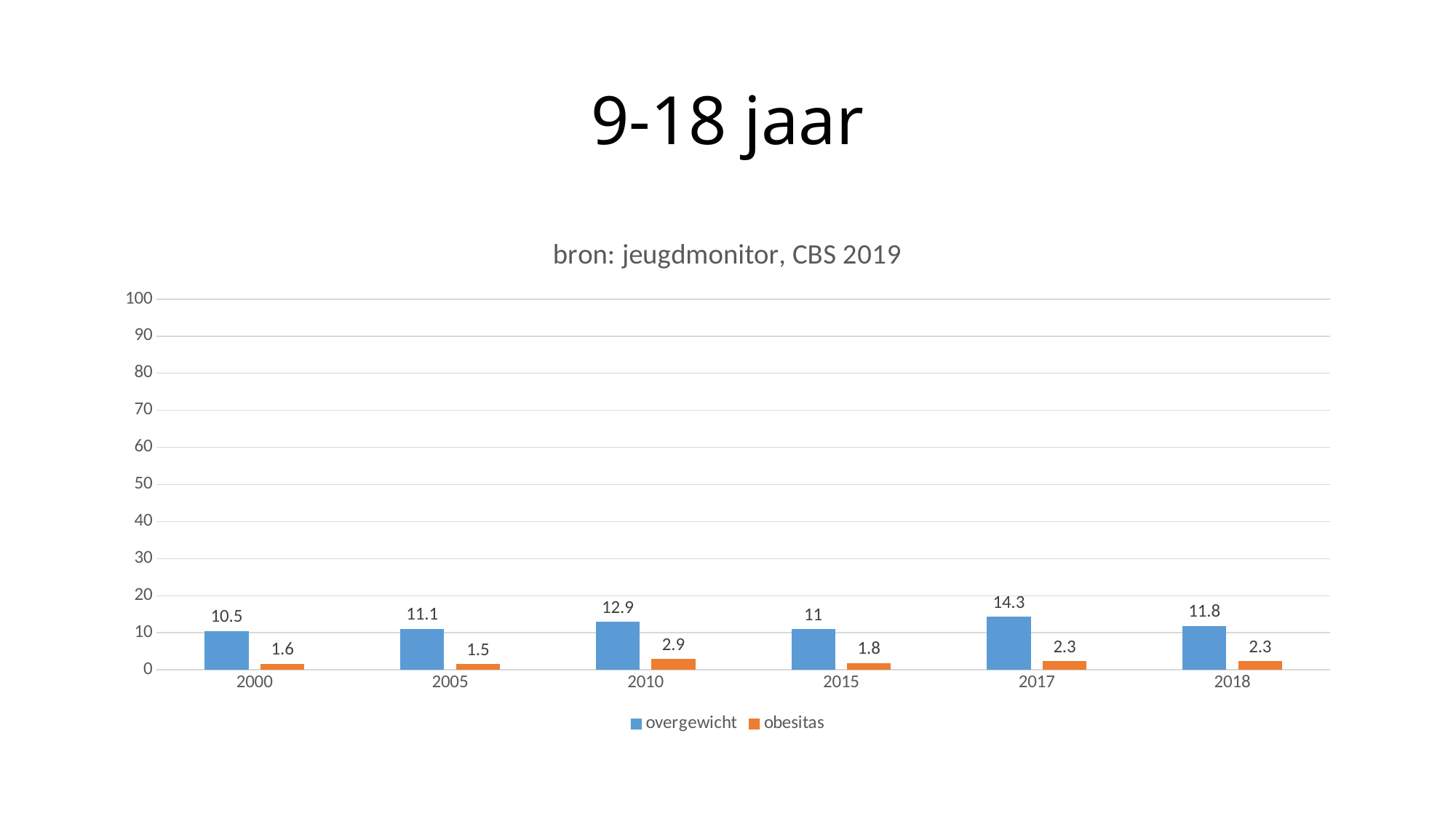
What is the value for overgewicht in 2010? 12.9 Which is larger, the obesitas value for 2010 or for 2018? 2010 In which year is the overgewicht value highest? 2017 What is the value for obesitas in 2015? 1.8 What is the difference between the overgewicht values for 2017 and 2000? 3.8 Which colour represents obesitas in the chart? orange In which year is the obesitas value lowest? 2005 What kind of chart is shown on the slide? bar chart Is the overgewicht value for 2017 greater or less than 20? less What is the title of the chart? bron: jeugdmonitor, CBS 2019 How many years are shown on the x axis? 6 How many series does the legend list? 2